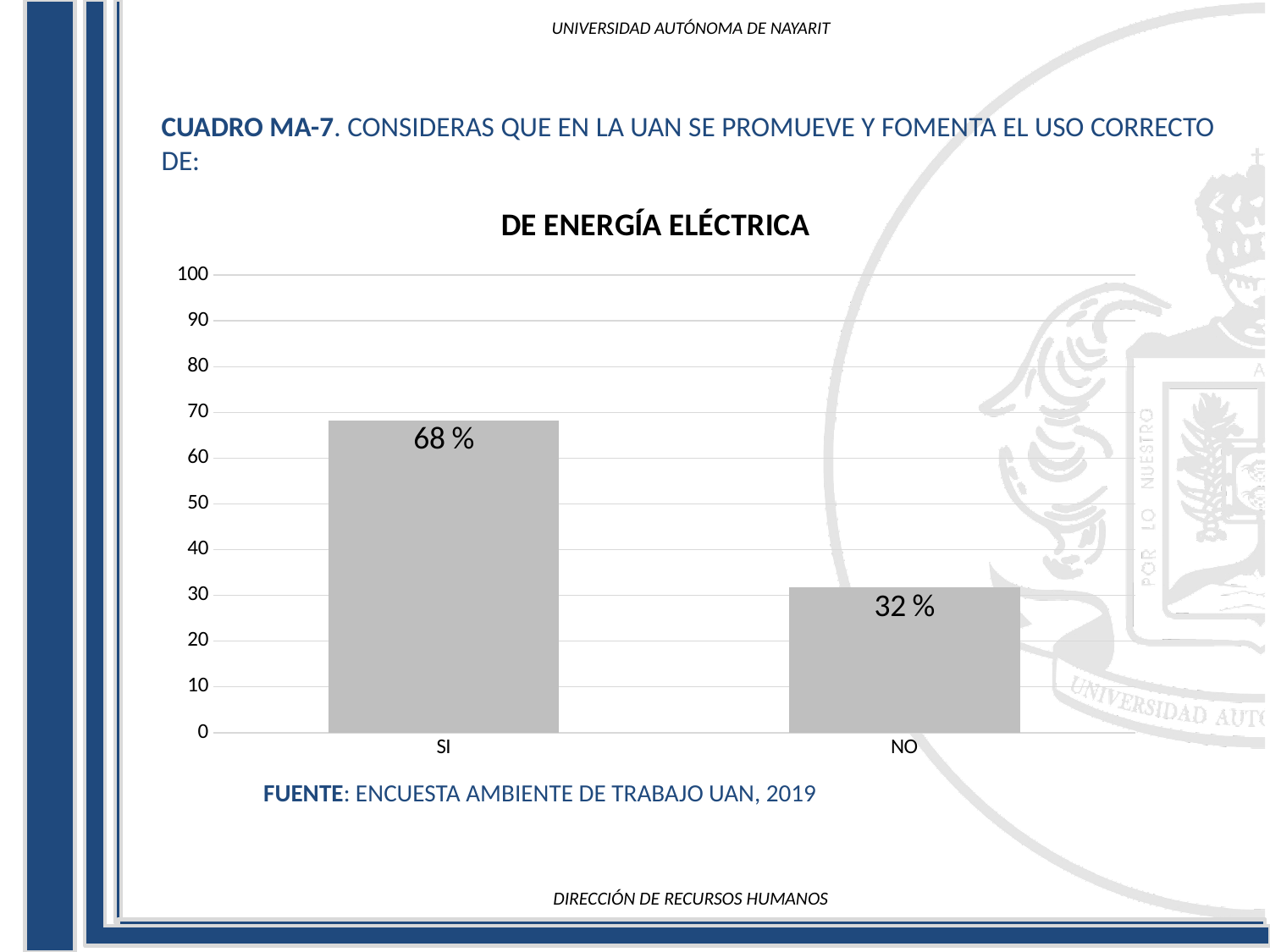
Which is larger, the value for SI or the value for NO? SI What is the value for NO? 32 % What is the maximum value shown on the vertical axis? 100 Which category has the highest value? SI Which category has the lowest value? NO What is the difference between the values for SI and NO? 36 % What kind of chart is shown? bar chart What is the title of the chart? DE ENERGÍA ELÉCTRICA What is the value for SI? 68 % Is the value for SI greater or less than 60? greater How many categories are shown on the x axis? 2 Is the value for NO greater or less than 40? less